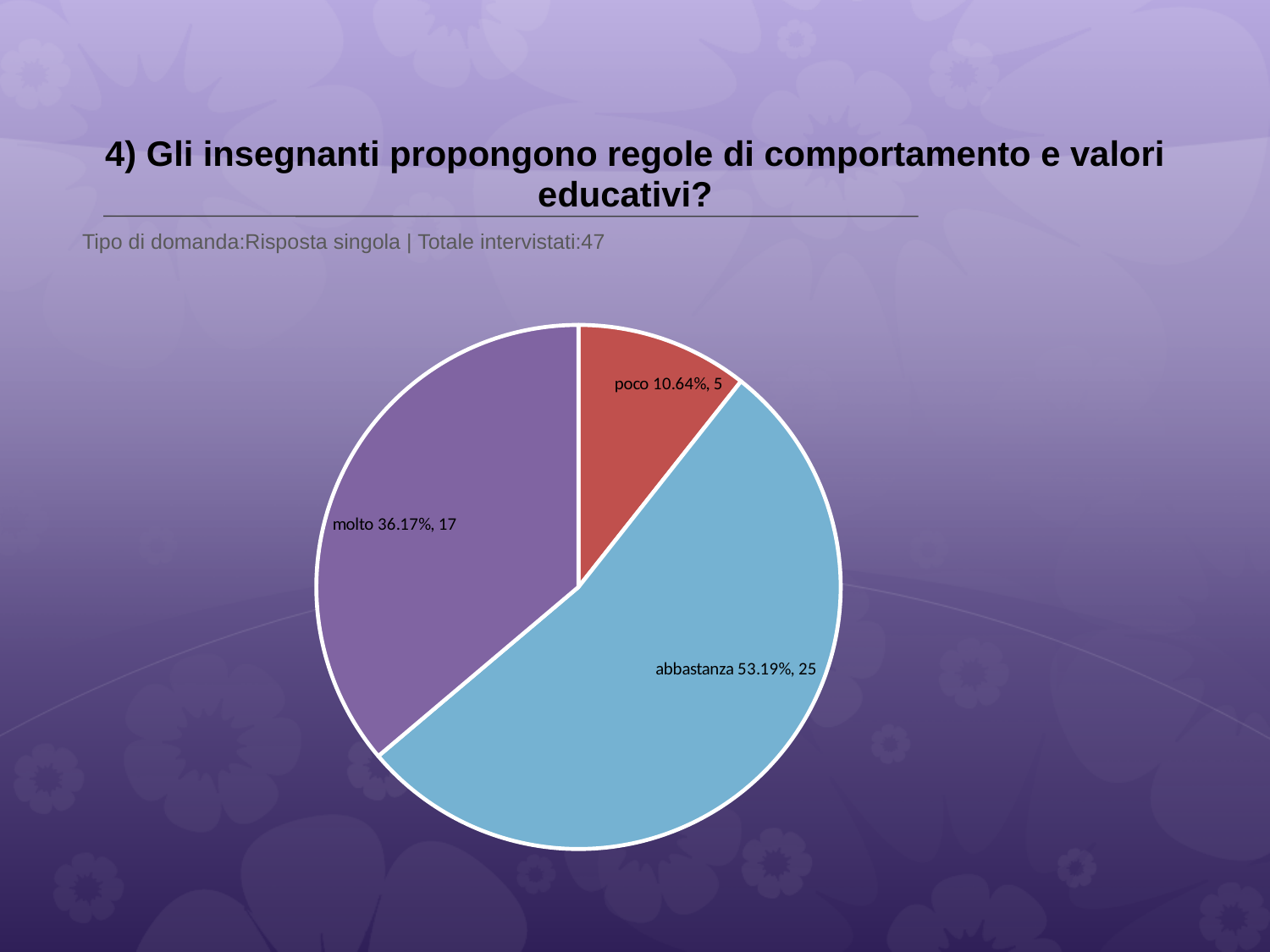
Which response category has the smallest slice? poco What percentage share does the 'poco' slice have? 10.64% How many respondents answered 'molto'? 17 How many respondents answered 'abbastanza'? 25 What percentage share does the 'molto' slice have? 36.17% What is the difference in respondent count between 'abbastanza' and 'molto'? 8 Which response category has the largest slice? abbastanza What kind of chart is shown on the slide? pie chart How many slices does the pie chart have? 3 Which slice is larger, 'molto' or 'poco'? molto How many respondents answered 'poco'? 5 What percentage share does the 'abbastanza' slice have? 53.19%